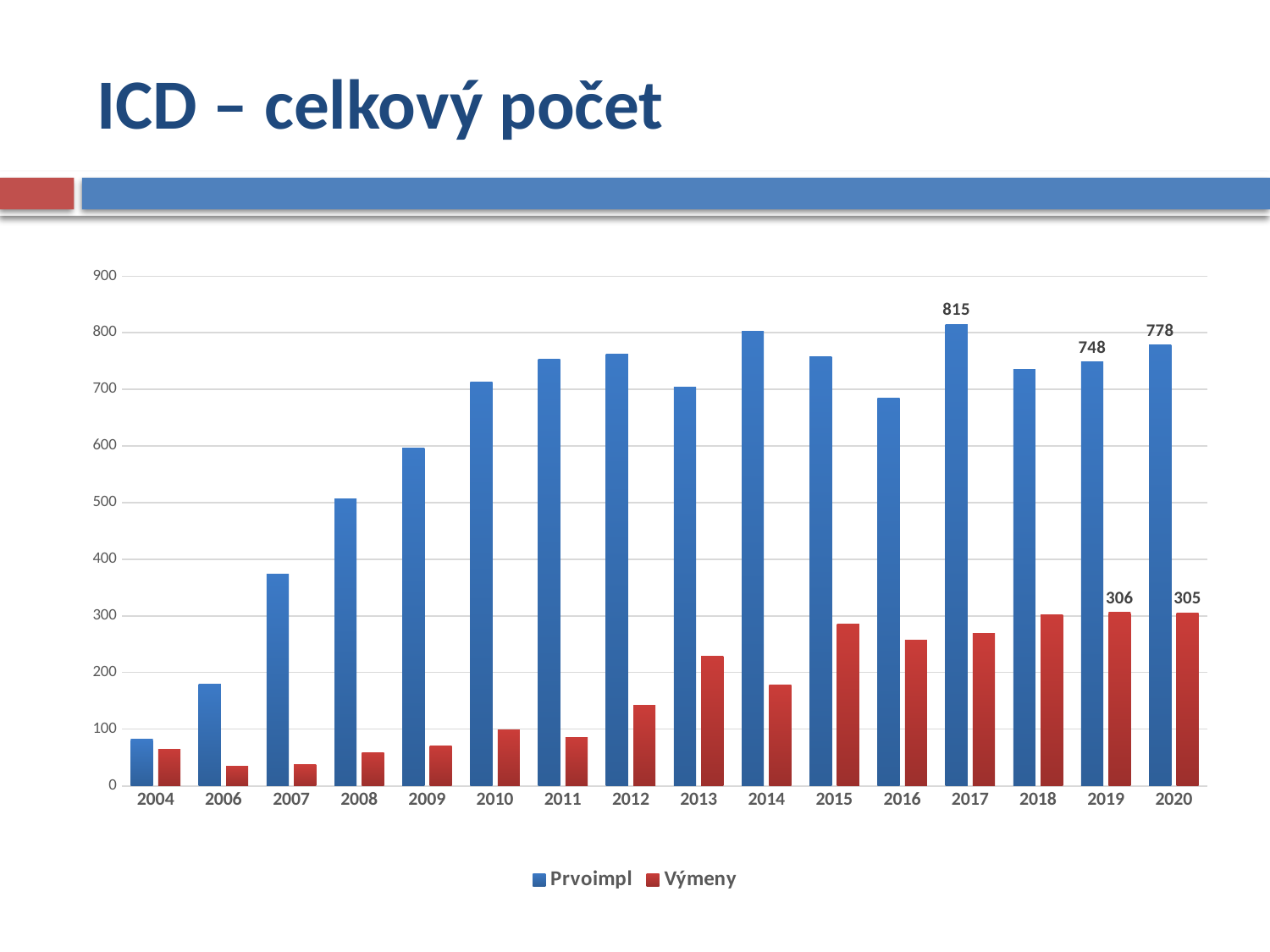
Is the Prvoimpl value for 2009 greater or less than 500? greater What is the value of Prvoimpl for 2020? 778 What is the value of Prvoimpl for 2017? 815 Which year has the lowest Prvoimpl value? 2004 Which year has the larger Prvoimpl value, 2019 or 2020? 2020 What is the difference between the Prvoimpl values for 2020 and 2019? 30 What is the difference between the Výmeny values for 2019 and 2020? 1 What is the value of Výmeny for 2019? 306 What kind of chart is shown on the slide? bar chart Is the Výmeny value for 2013 greater or less than 200? greater How many series does the legend list? 2 How many years are shown on the x axis? 16